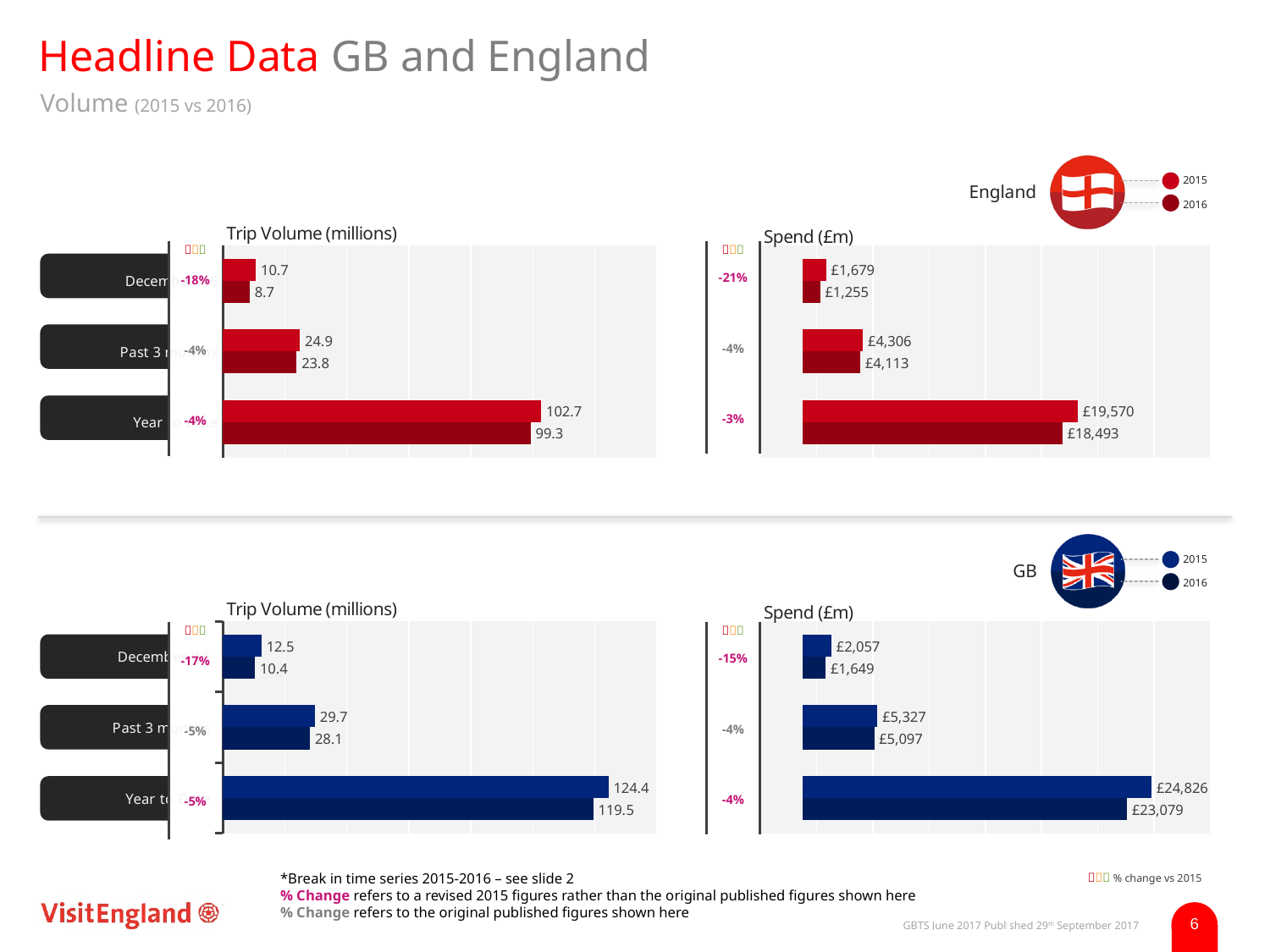
In the England Trip Volume (millions) chart, what is the difference between the 2015 and 2016 values for the Past 3 months row? 1.1 In the GB Spend (£m) chart, what is the difference between the 2015 and 2016 values for the Year row? £1,747 How many series does the legend list for the GB charts? 2 In the GB Trip Volume (millions) chart, which row has the highest 2015 value? Year What type of chart is the England Spend (£m) chart? bar chart What percentage change is shown next to the December row in the GB Spend (£m) chart? -15% In the England Spend (£m) chart, what is the 2015 value for the Year row? £19,570 In the England Trip Volume (millions) chart, is the 2015 value for December larger or smaller than the 2016 value for December? larger In the England Spend (£m) chart, which row has the lowest 2016 value? December In the GB Spend (£m) chart, what is the 2016 value for the Past 3 months row? £5,097 In the GB Trip Volume (millions) chart, what is the 2015 value for the December row? 12.5 In the England Trip Volume (millions) chart, what is the 2016 value for the Year row? 99.3